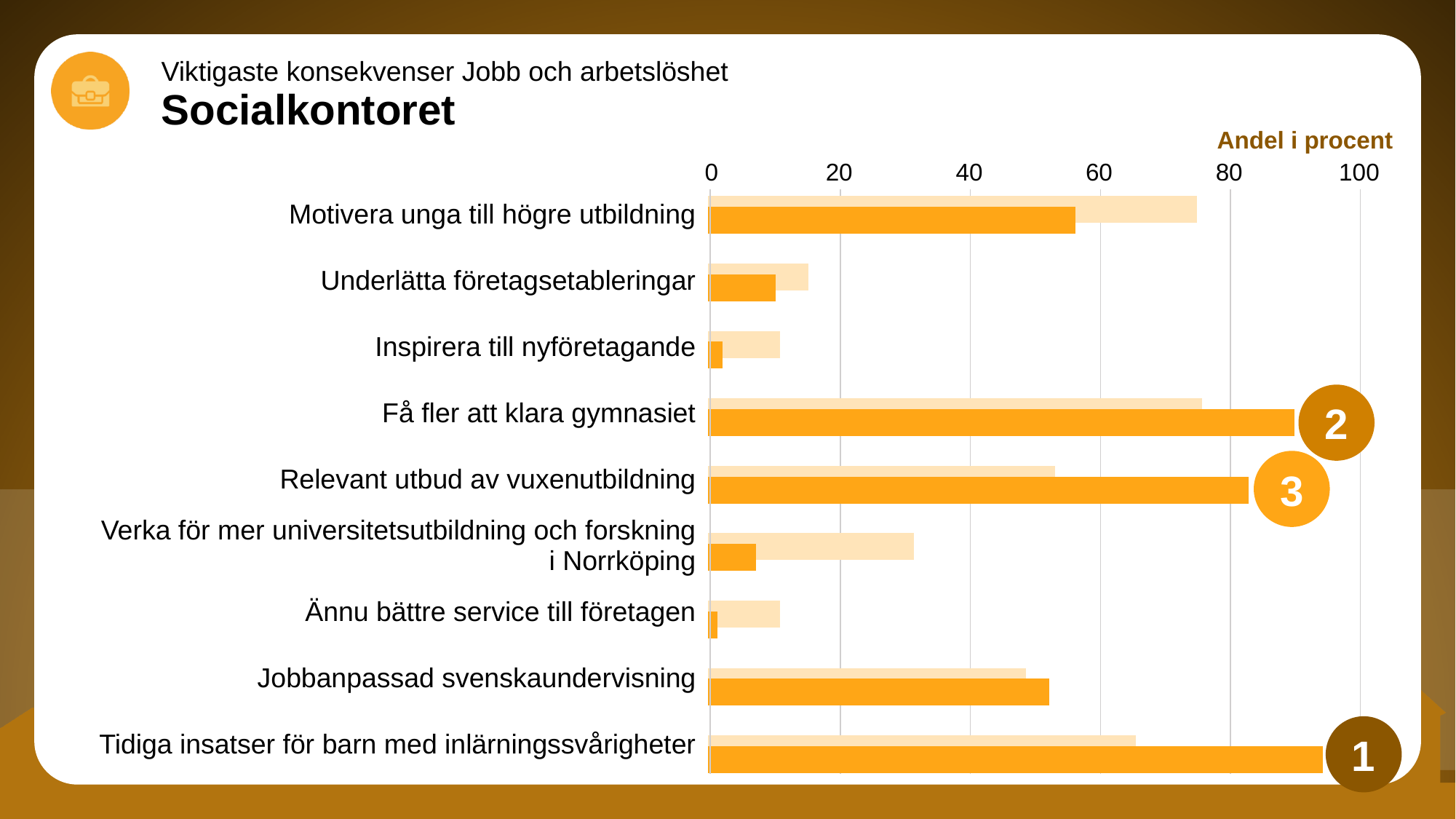
How many categories are plotted on the chart? 9 For Relevant utbud av vuxenutbildning, which bar is longer: the dark orange or the light orange? dark orange Which category has the longest dark orange bar? Tidiga insatser för barn med inlärningssvårigheter What is the title of the slide containing the chart? Socialkontoret Is the dark orange value for Jobbanpassad svenskaundervisning greater or less than 40? greater What is the label shown above the value axis of the chart? Andel i procent Which has the larger dark orange value: Få fler att klara gymnasiet or Motivera unga till högre utbildning? Få fler att klara gymnasiet What kind of chart is shown on the slide? bar chart Is the light orange value for Verka för mer universitetsutbildning och forskning i Norrköping greater or less than 40? less Is the dark orange value for Underlätta företagsetableringar greater or less than 20? less